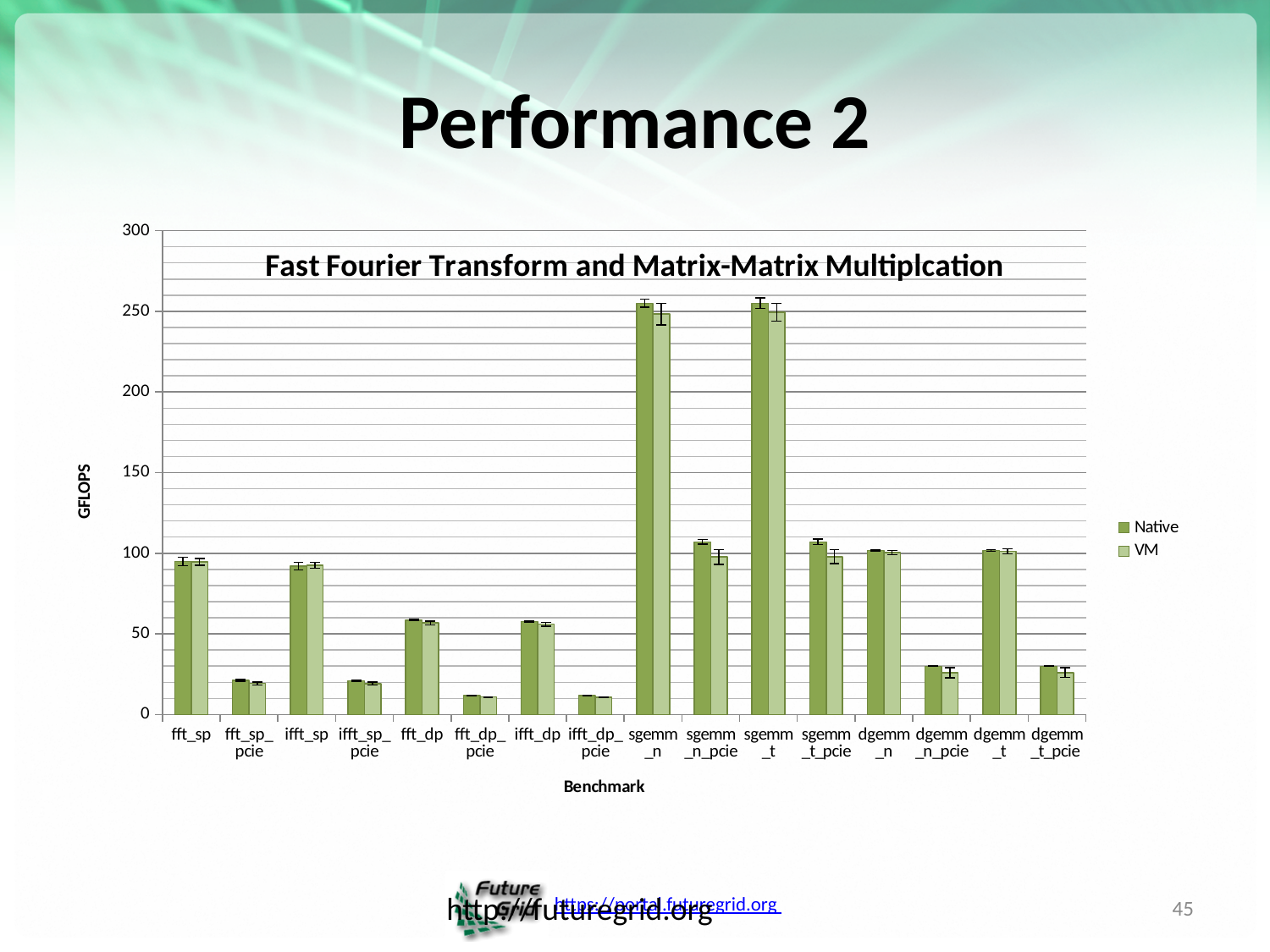
How many series does the chart legend list? 2 How many benchmark categories are shown on the x axis? 16 What kind of chart is shown on the slide? bar chart Is the Native value for sgemm_n greater or less than 250? greater Is the Native value for dgemm_n_pcie greater or less than 50? less Is the Native value for fft_sp greater or less than 100? less Which is larger, the Native value for fft_sp or the Native value for fft_sp_pcie? fft_sp Which is larger, the Native value for sgemm_n or the Native value for sgemm_n_pcie? sgemm_n What is the title of the chart? Fast Fourier Transform and Matrix-Matrix Multiplcation What is the label of the y axis? GFLOPS